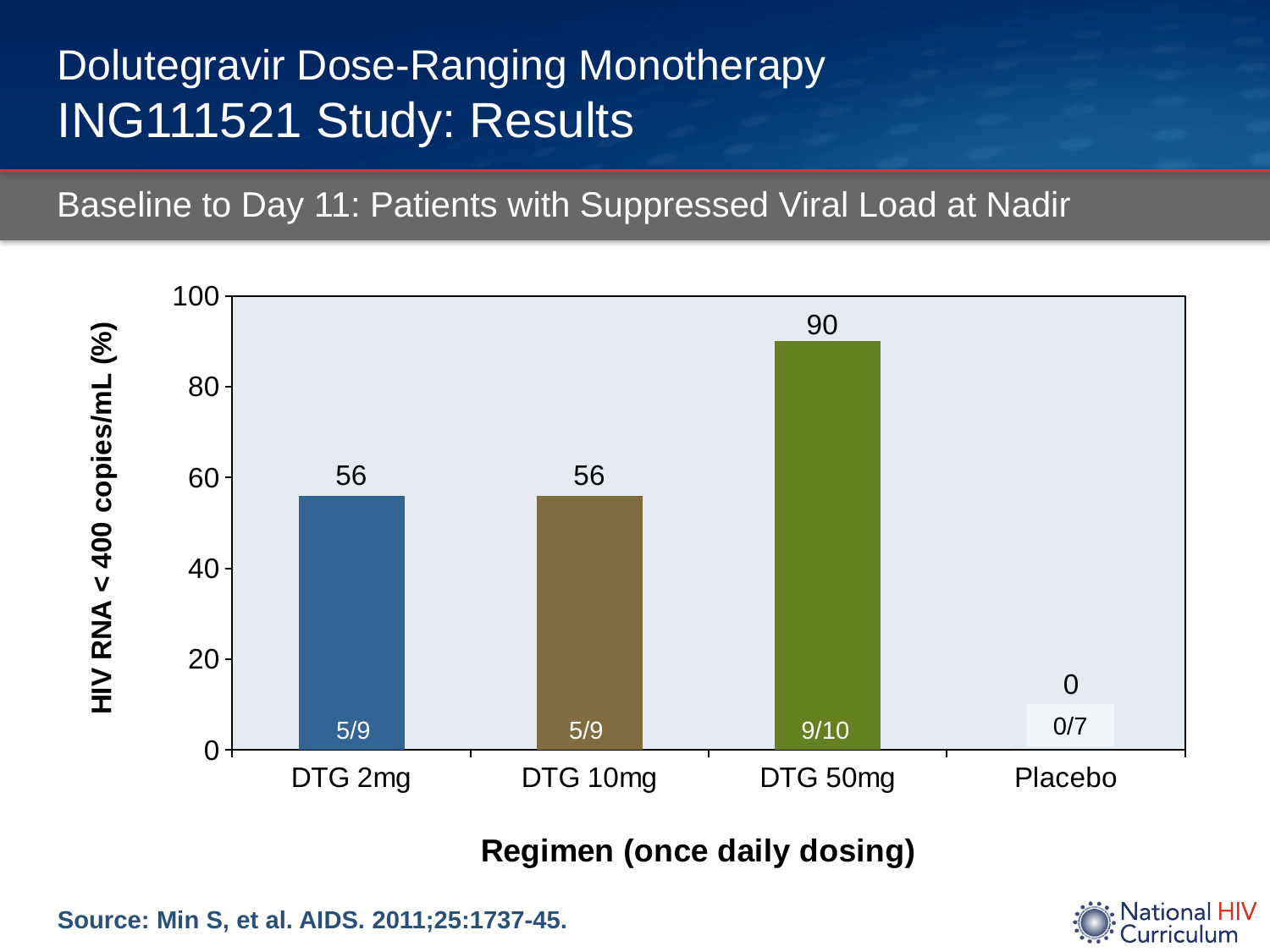
What is the x-axis title of the chart? Regimen (once daily dosing) Which regimen has the highest value? DTG 50mg What fraction of patients is shown for Placebo? 0/7 How many regimens are shown on the x axis? 4 What is the difference between the values for DTG 50mg and DTG 10mg? 34 Which regimen has the lowest value? Placebo Which is larger, the value for DTG 50mg or the value for DTG 2mg? DTG 50mg What fraction of patients is shown inside the DTG 50mg bar? 9/10 What is the value for DTG 50mg? 90 What is the value for Placebo? 0 What is the value for DTG 2mg? 56 What kind of chart is this? Bar chart